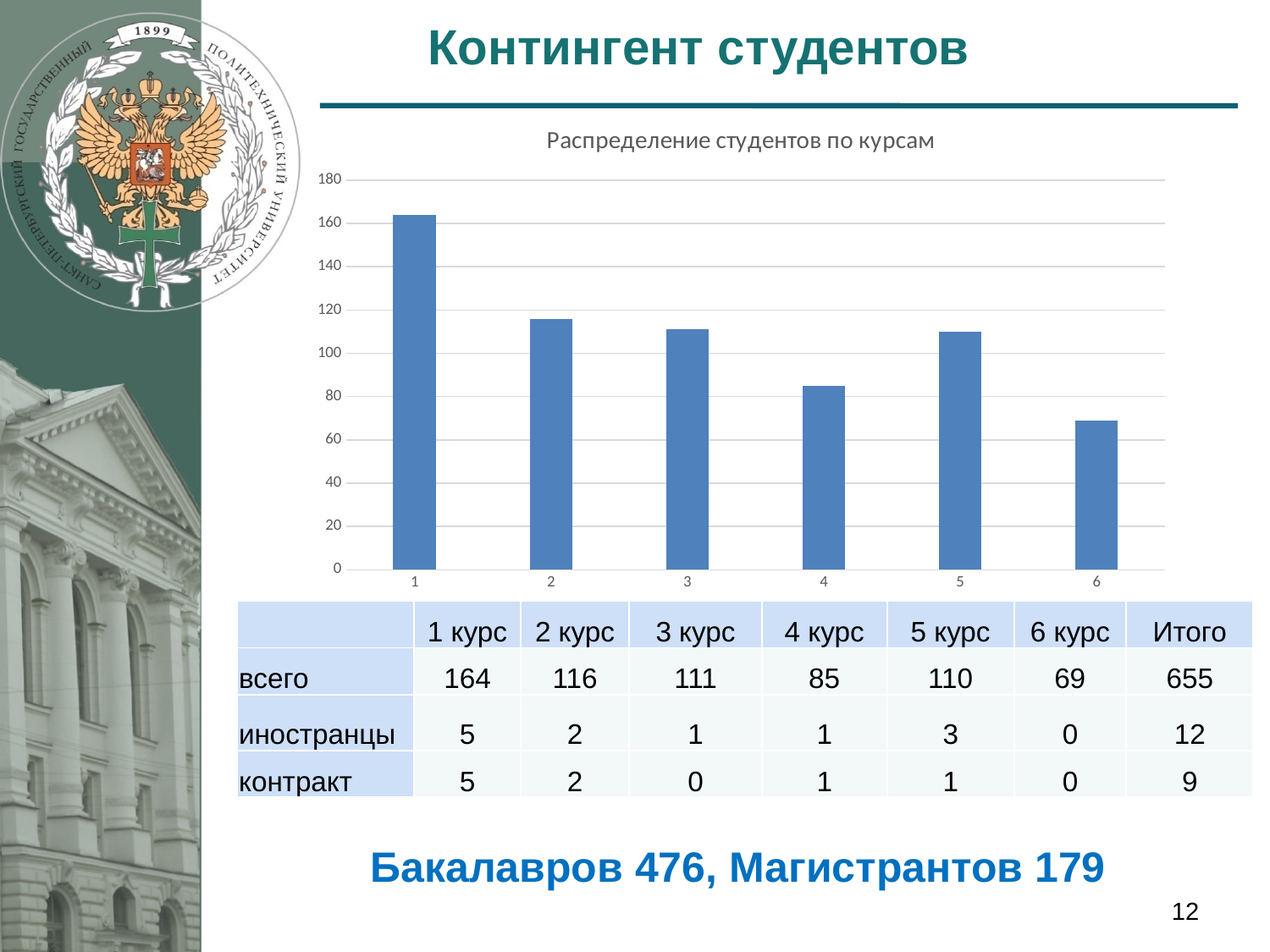
Which has more students, course 4 or course 6? course 4 From course 1 to course 4, do the values rise or fall? fall What is the number of students for course 4? 85 What is the title of the chart? Распределение студентов по курсам What kind of chart is shown on the slide? bar chart What is the number of students for course 1? 164 Is the value for course 1 greater or less than 160? greater What is the difference between the number of students in course 1 and course 2? 48 Is the value for course 6 greater or less than 80? less How many courses (categories) are plotted on the x axis of the chart? 6 Which course has the lowest number of students in the chart? 6 Which course has the highest number of students in the chart? 1